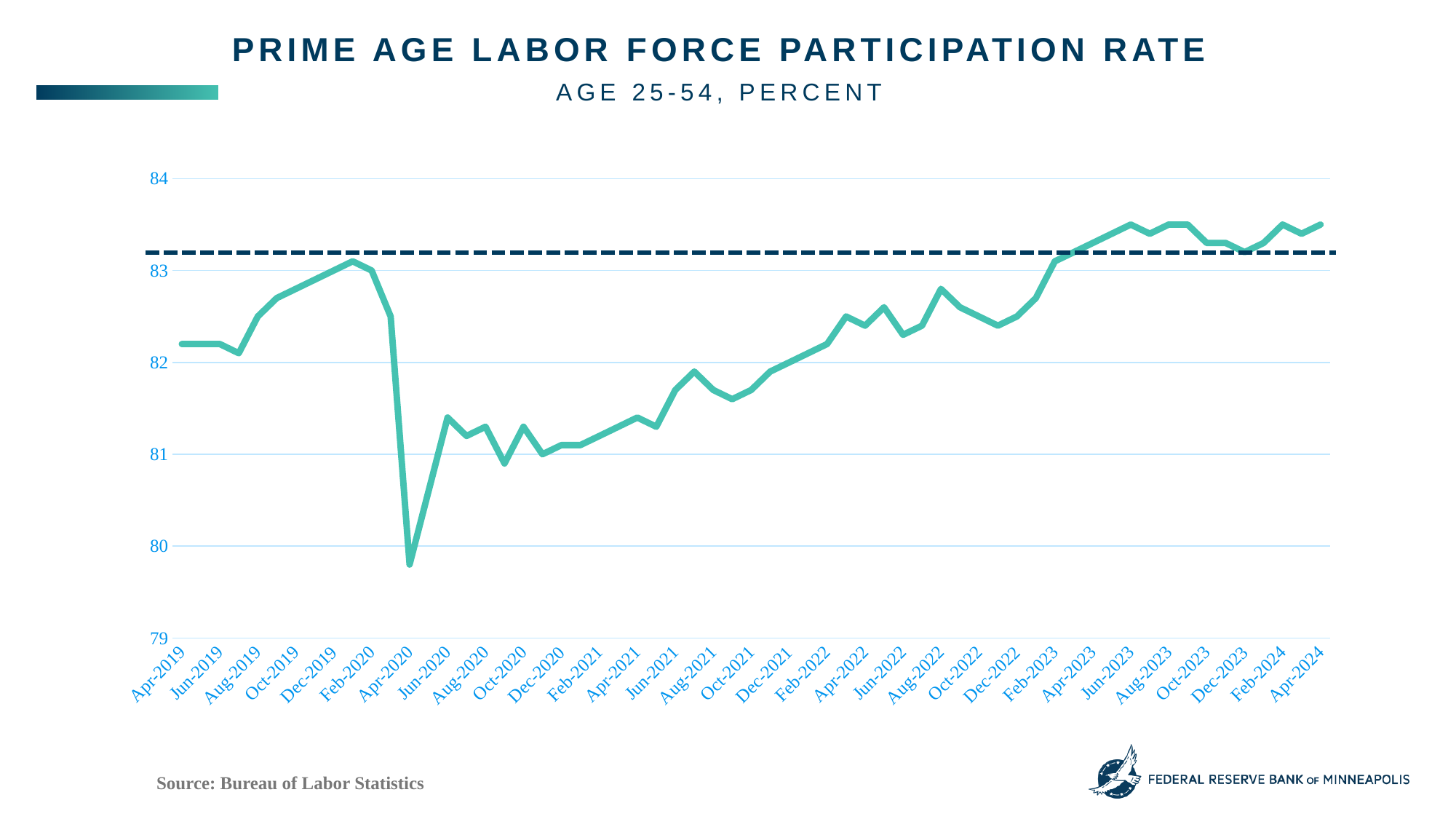
Is the value for Dec-2020 greater or less than 82? less What is the highest value shown on the vertical axis? 84 What kind of chart is shown on the slide? line chart Is the value for Apr-2019 greater or less than 83? less Is the value for Apr-2024 greater or less than 83? greater Does the participation rate generally rise or fall from Apr-2020 to Apr-2024? rise What is the title of the chart? Prime Age Labor Force Participation Rate What is the source cited for the chart's data? Bureau of Labor Statistics In which month does the participation rate reach its lowest point? Apr-2020 Which is larger, the value for Apr-2024 or the value for Apr-2020? Apr-2024